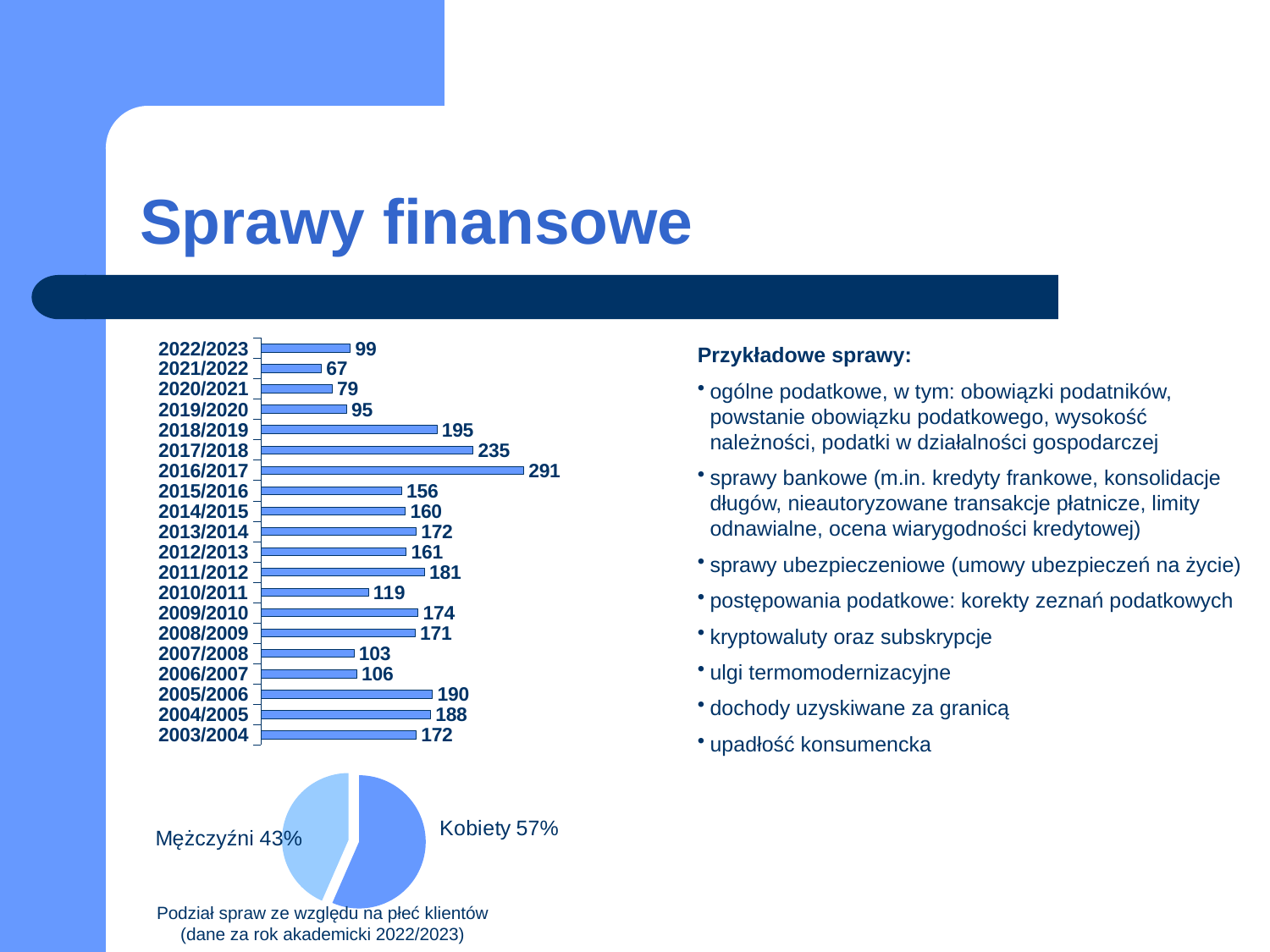
In the bar chart on the left of the slide, what is the value for 2016/2017? 291 What kind of chart is the chart at the top left of the slide? Bar chart In the bar chart on the left of the slide, which is larger, the value for 2011/2012 or the value for 2010/2011? 2011/2012 In the bar chart on the left of the slide, what is the value for 2022/2023? 99 In the bar chart on the left of the slide, which year has the lowest value? 2021/2022 How many years (categories) are shown in the bar chart on the left of the slide? 20 In the bar chart on the left of the slide, which year has the highest value? 2016/2017 In the bar chart on the left of the slide, what is the difference between the values for 2017/2018 and 2018/2019? 40 In the pie chart at the bottom left of the slide, what share is labelled Kobiety? 57% What is the caption of the pie chart at the bottom left of the slide? Podział spraw ze względu na płeć klientów (dane za rok akademicki 2022/2023) In the bar chart on the left of the slide, what is the value for 2005/2006? 190 In the pie chart at the bottom left of the slide, what share is labelled Mężczyźni? 43%